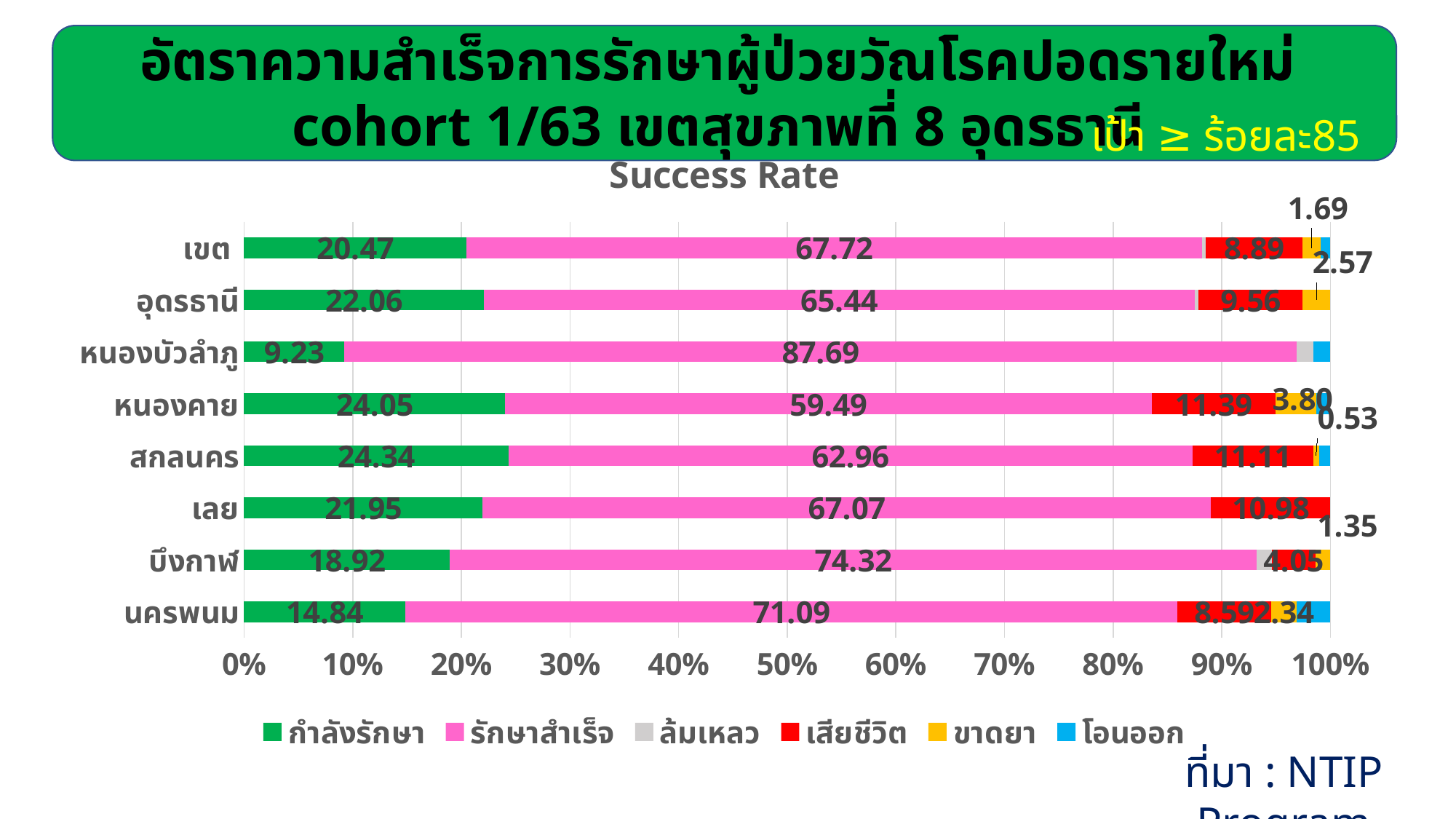
What is the เสียชีวิต value for หนองคาย? 11.39 How many categories (rows) are plotted in the Success Rate chart? 8 What type of chart is shown on the slide? stacked bar chart What is the title of the chart? Success Rate What is the รักษาสำเร็จ value for หนองบัวลำภู? 87.69 What is the กำลังรักษา value for อุดรธานี? 22.06 What is the difference between the รักษาสำเร็จ values of บึงกาฬ and นครพนม? 3.23 Which is larger, the รักษาสำเร็จ value for เขต or for เลย? เขต Which category has the lowest กำลังรักษา value? หนองบัวลำภู How many series does the legend of the Success Rate chart list? 6 Is the รักษาสำเร็จ value for หนองคาย greater or less than 60? less Which category has the highest รักษาสำเร็จ value? หนองบัวลำภู